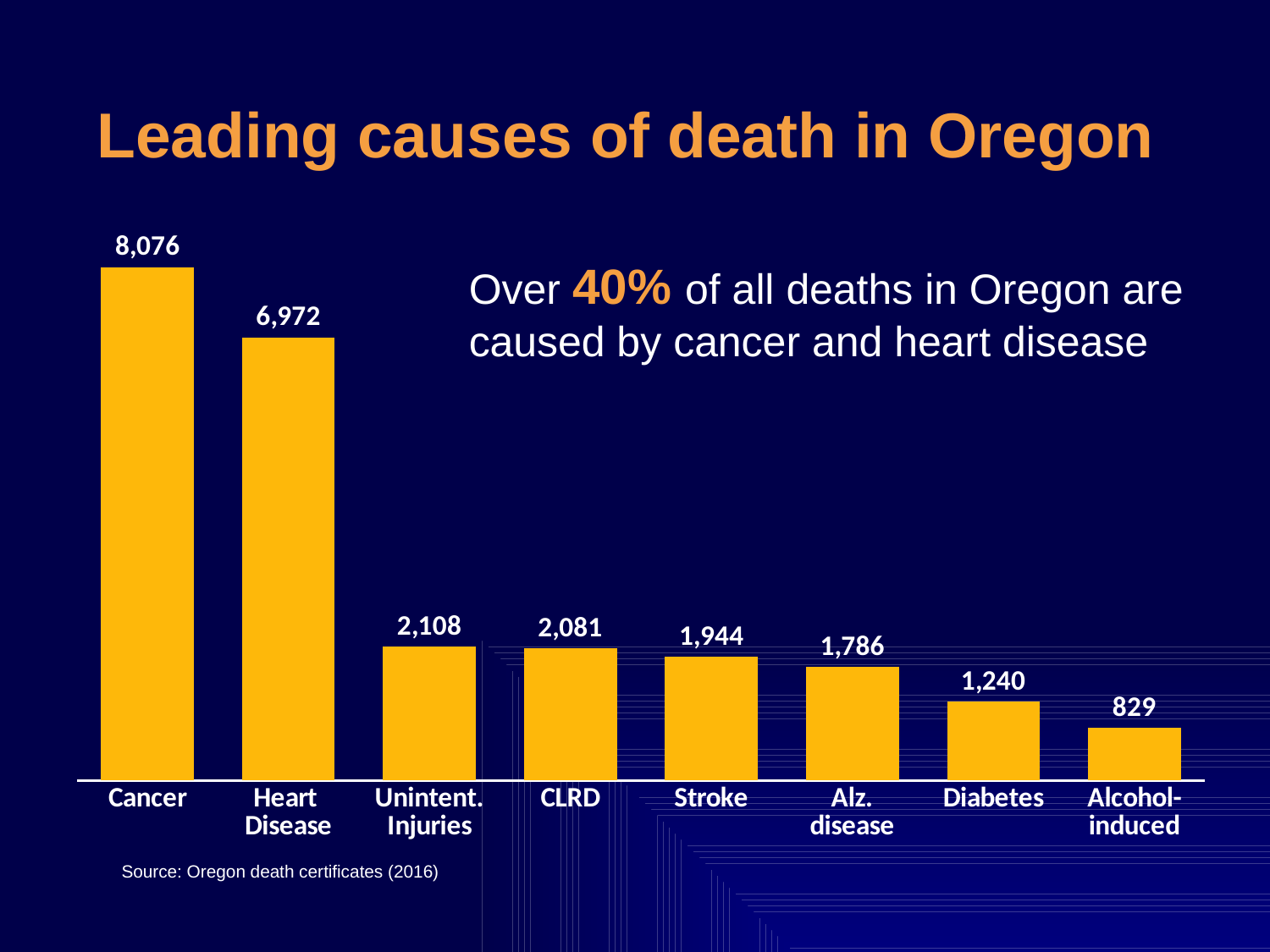
What is the value shown for Alcohol-induced deaths? 829 What is the difference between the values for Diabetes and Alcohol-induced? 411 How many deaths are attributed to Cancer? 8,076 What is the difference between the values for Cancer and Heart Disease? 1,104 What is the value shown for Stroke? 1,944 What type of chart is shown on the slide? Bar chart How many causes of death are shown in the chart? 8 Do the values rise or fall from left to right across the chart? Fall Which cause of death has the highest value? Cancer Which is larger, the value for Unintent. Injuries or the value for CLRD? Unintent. Injuries Which cause of death has the lowest value? Alcohol-induced Which is larger, the value for Alz. disease or the value for Diabetes? Alz. disease